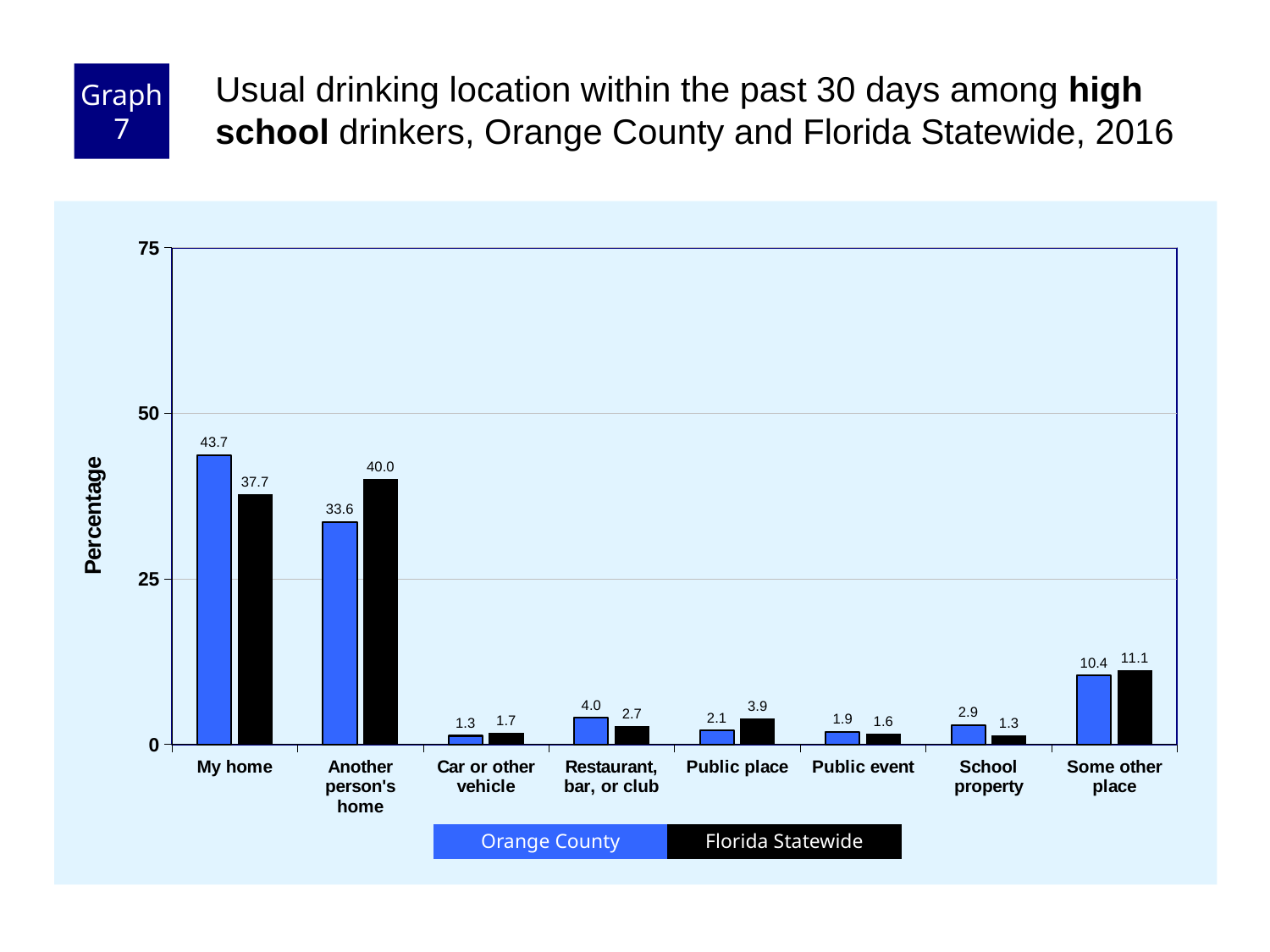
Is the Florida Statewide value for Another person's home greater or less than 25? greater What is the difference between the Orange County and Florida Statewide values for My home? 6.0 For Public place, which is larger: Orange County or Florida Statewide? Florida Statewide What is the label of the y axis? Percentage What is the Florida Statewide value for Another person's home? 40.0 Which category has the highest Orange County value? My home What is the Orange County value for My home? 43.7 What is the Orange County value for Some other place? 10.4 How many series does the legend list? 2 What kind of chart is shown? Bar chart How many location categories are shown on the x axis? 8 Which category has the lowest Florida Statewide value? School property